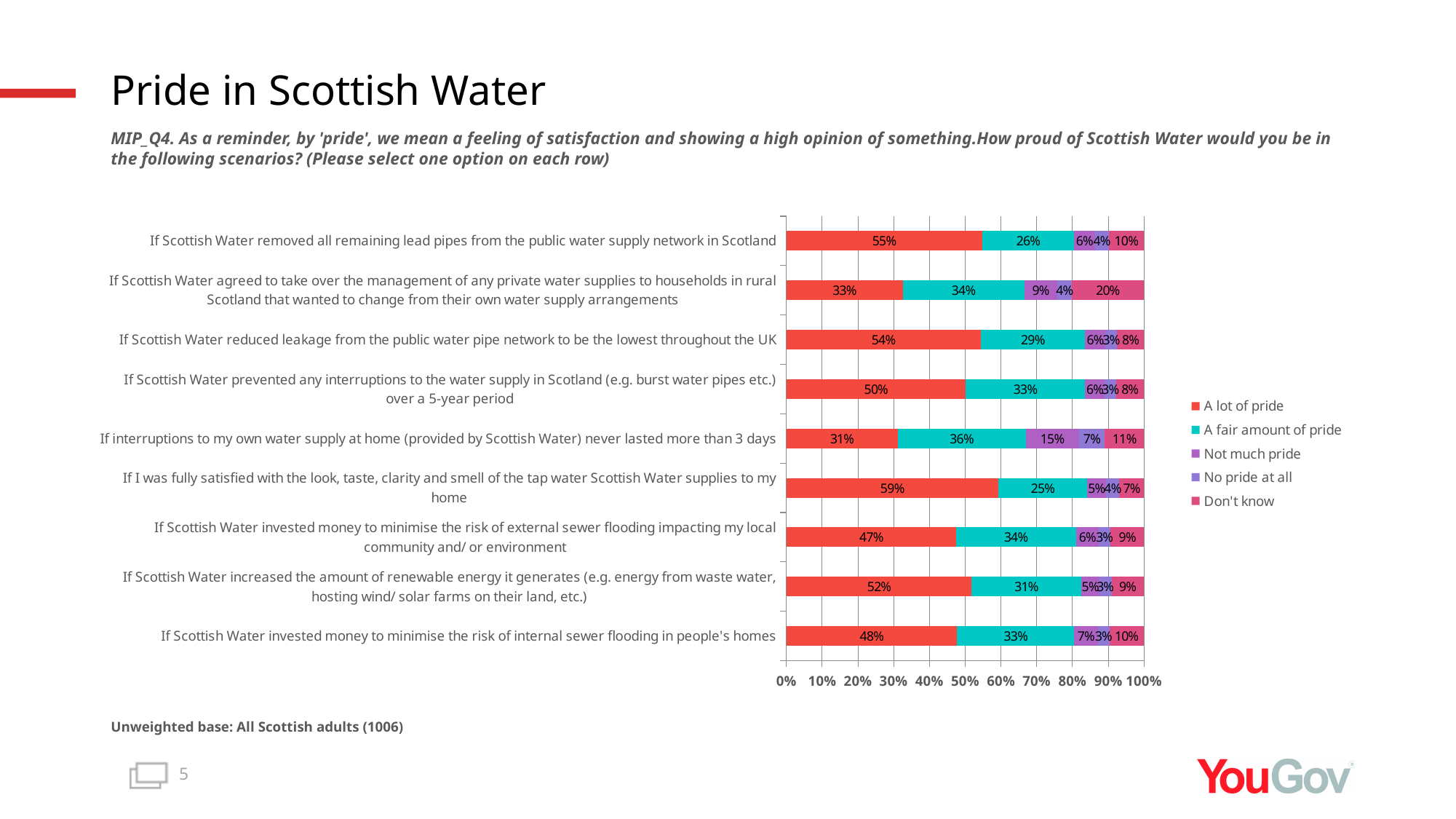
What percentage of respondents would feel 'A lot of pride' if Scottish Water removed all remaining lead pipes from the public water supply network in Scotland? 55% How many scenarios (bars) are shown in the chart? 9 How many series does the legend list? 5 Which has a larger 'A fair amount of pride' value: the reduced leakage scenario or the renewable energy scenario? The renewable energy scenario (31% vs 29%) What is the difference between the 'A lot of pride' values for the lead pipes scenario (55%) and the private water supplies scenario (33%)? 22 percentage points What is the 'Don't know' value for the scenario where Scottish Water agreed to take over the management of private water supplies in rural Scotland? 20% What type of chart is shown on the slide? Stacked bar chart Which scenario has the highest 'A lot of pride' value? If I was fully satisfied with the look, taste, clarity and smell of the tap water Scottish Water supplies to my home Which legend entry is shown in red? A lot of pride What is the combined share of 'A lot of pride' and 'A fair amount of pride' for the internal sewer flooding scenario? 81% What percentage would feel 'Not much pride' if interruptions to their own water supply at home never lasted more than 3 days? 15% Which scenario has the lowest 'A lot of pride' value? If interruptions to my own water supply at home (provided by Scottish Water) never lasted more than 3 days